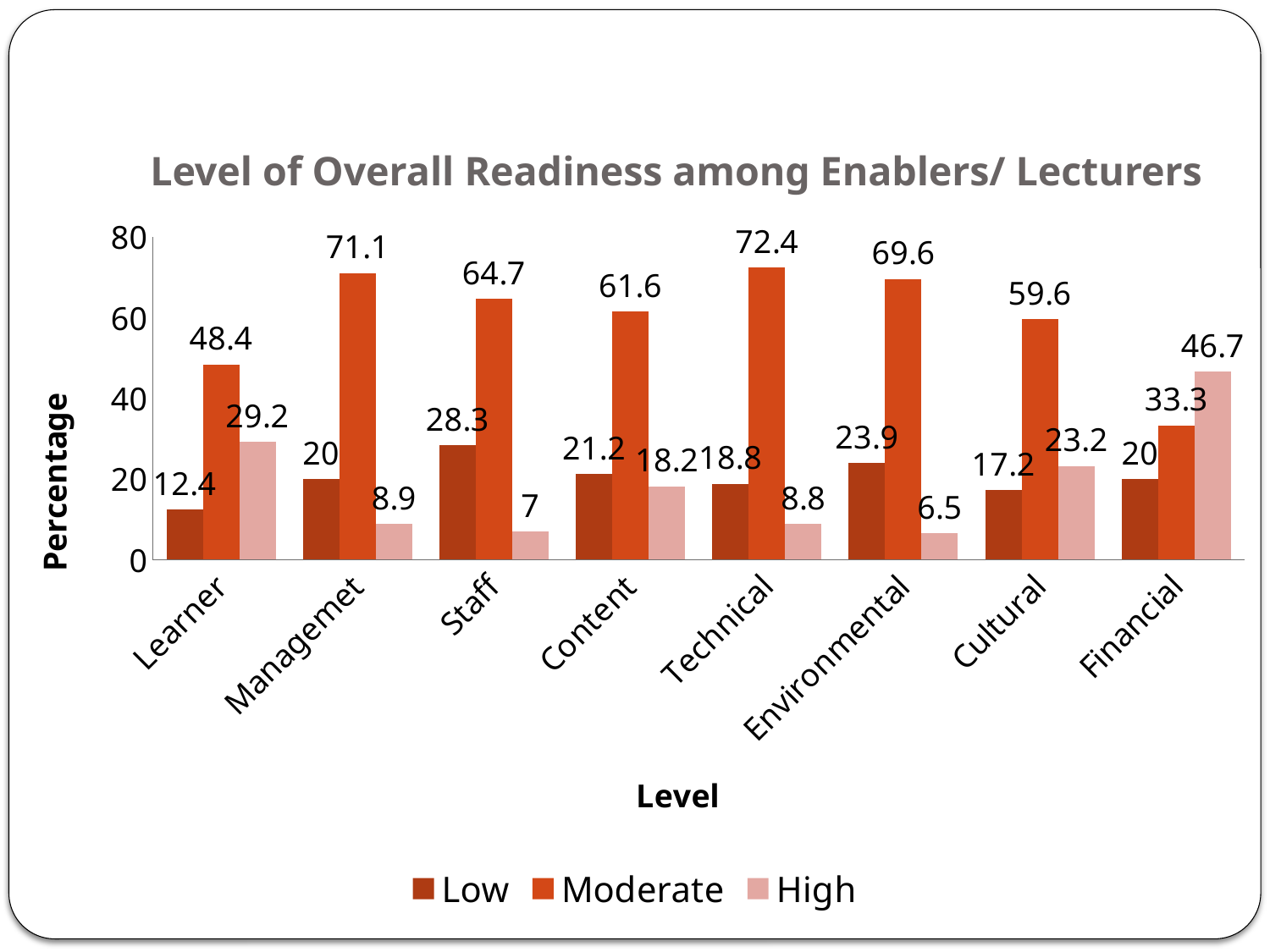
What is the High value for Financial? 46.7 Which category has the highest Moderate value? Technical What is the difference between the Moderate and High values for Financial? 13.4 How many categories are shown on the x axis? 8 What is the title of the chart? Level of Overall Readiness among Enablers/ Lecturers Which category has the lowest Low value? Learner What is the Low value for Staff? 28.3 Which category has the lowest High value? Environmental Which is larger, the High value for Learner or the High value for Cultural? Learner What is the Moderate value for Technical? 72.4 What kind of chart is shown? Bar chart How many series does the legend list? 3